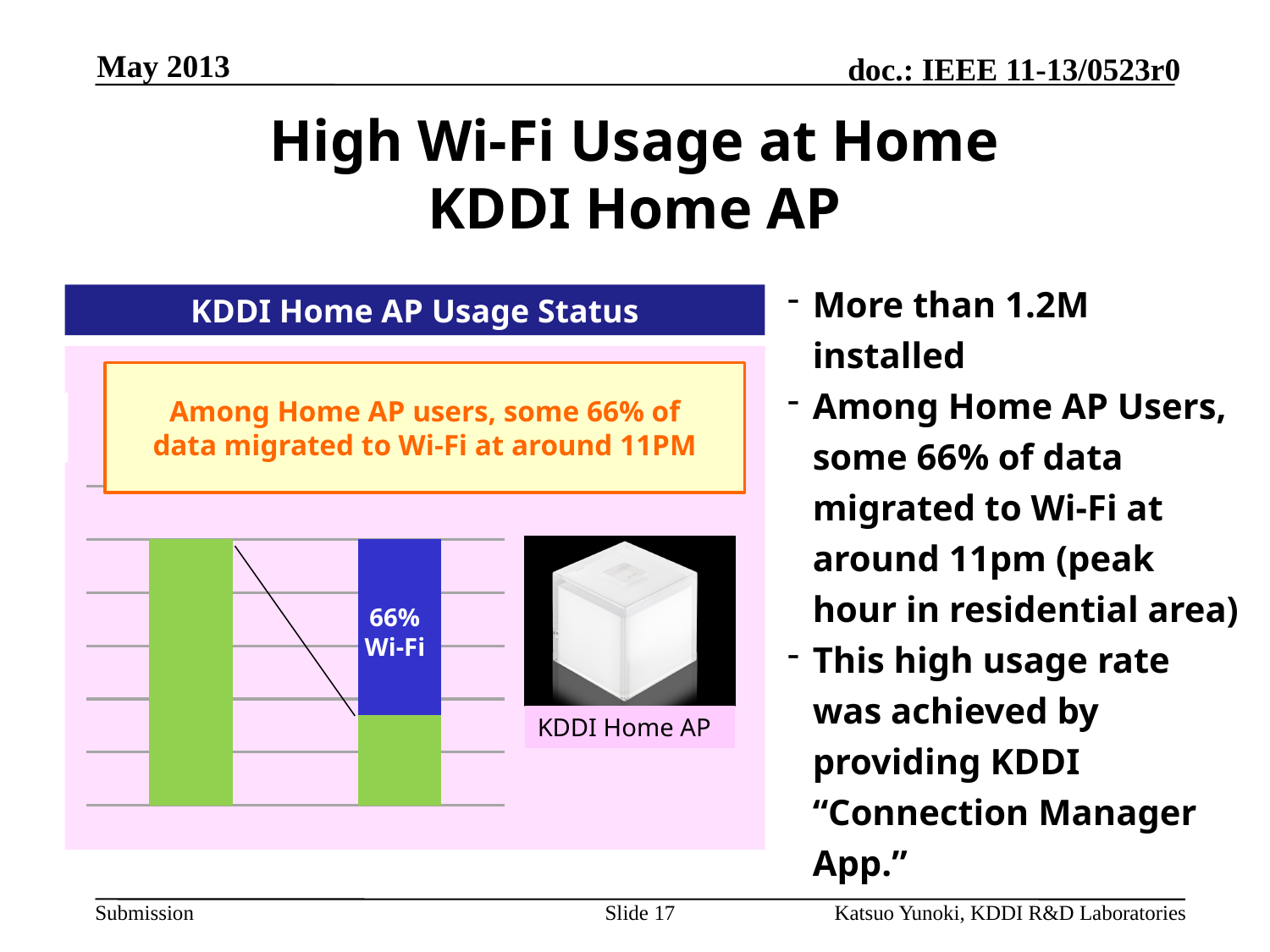
What is the title printed above the chart? KDDI Home AP Usage Status How many segments make up the left-hand bar? 1 What kind of chart is shown under the heading "KDDI Home AP Usage Status"? bar chart What percentage is labelled on the blue Wi-Fi segment of the right-hand bar? 66% How many bars are plotted in the KDDI Home AP Usage Status chart? 2 What colour is the segment labelled "66% Wi-Fi" in the right-hand bar? blue In the right-hand bar, which segment is larger, the blue Wi-Fi segment or the green segment? the blue Wi-Fi segment How many segments make up the right-hand bar? 2